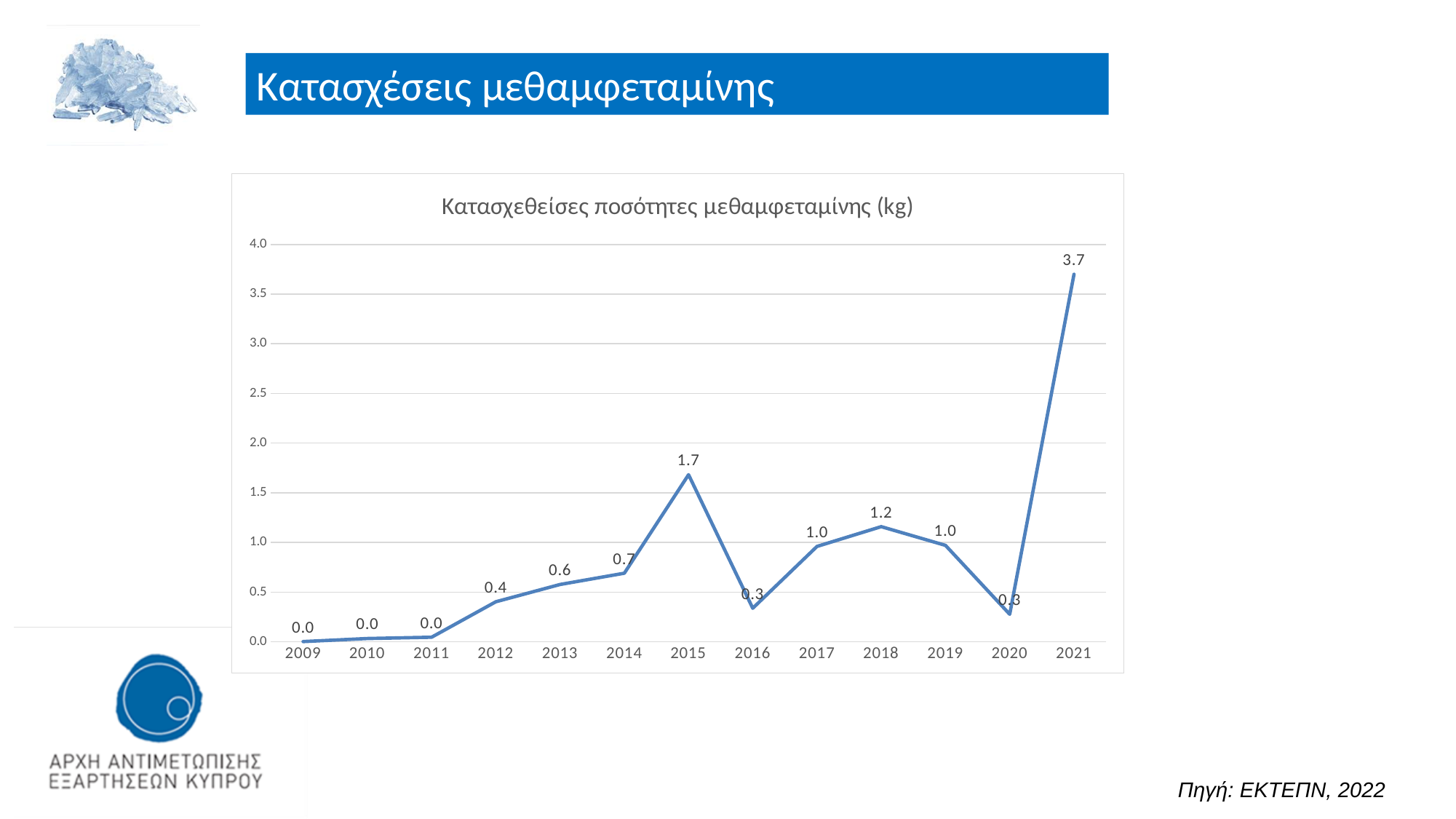
What kind of chart is shown? line chart Which year has the highest value? 2021 What is the difference between the values for 2021 and 2015? 2.0 What is the value for 2018? 1.2 Which is larger, the value for 2015 or the value for 2018? 2015 What is the difference between the values for 2018 and 2016? 0.9 How many years are shown on the x axis? 13 What is the title of the chart? Κατασχεθείσες ποσότητες μεθαμφεταμίνης (kg) What is the value for 2013? 0.6 Is the value for 2021 greater or less than 3.0? greater What is the value for 2015? 1.7 What is the value for 2021? 3.7